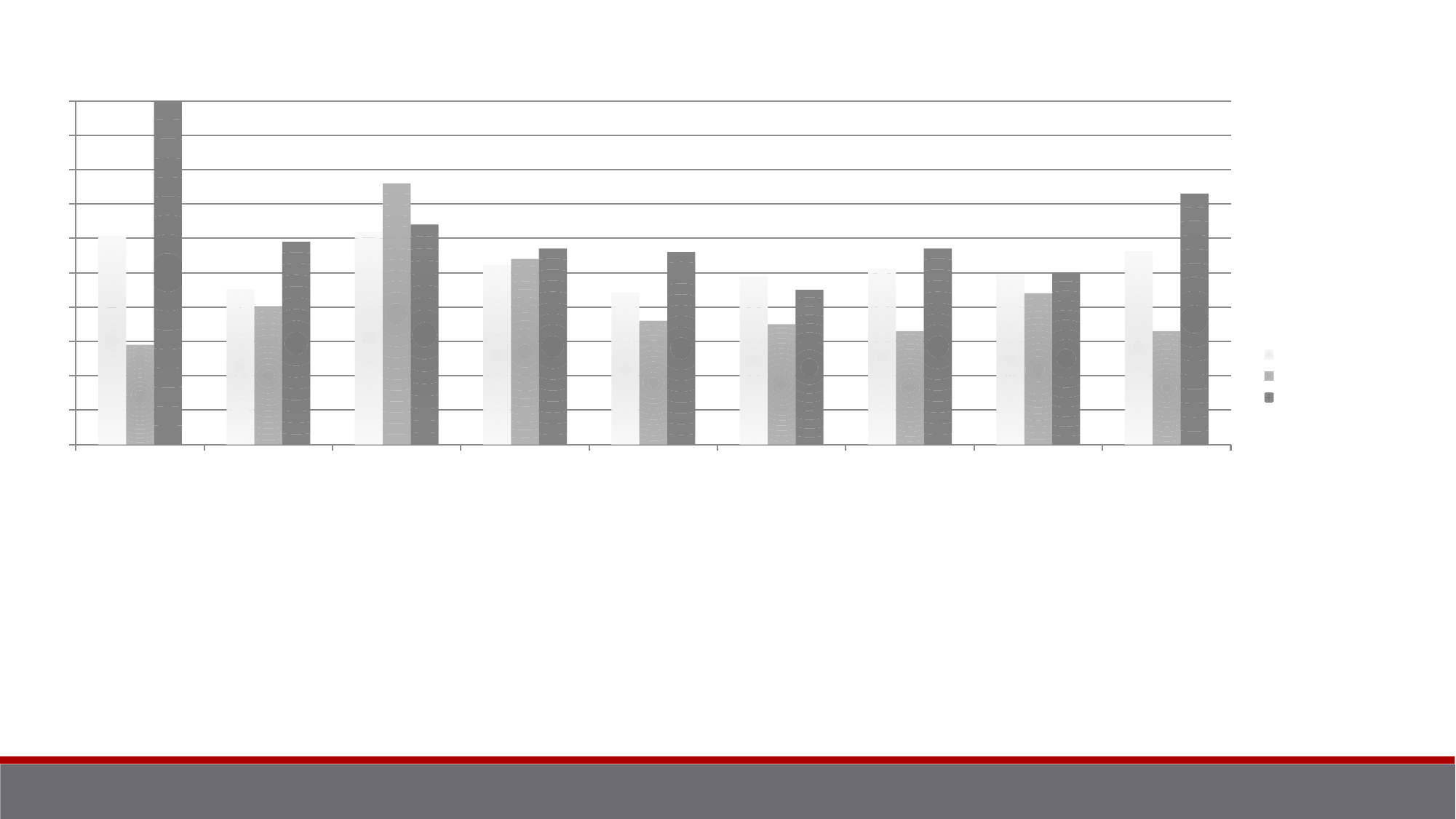
Counting from the left, which category group contains the tallest bar on the chart? the first group How many bars are in each category group? 3 What kind of chart is shown on the slide? bar chart Are the bars in the chart vertical or horizontal? vertical Does the chart display any data labels on the bars? no Within the third category group from the left, is the medium grey bar taller or shorter than the darkest bar? taller How many series does the legend list? 3 Within the first category group from the left, which series has the tallest bar: the lightest, the medium grey, or the darkest? the darkest How many groups of bars (categories) are plotted along the x axis? 9